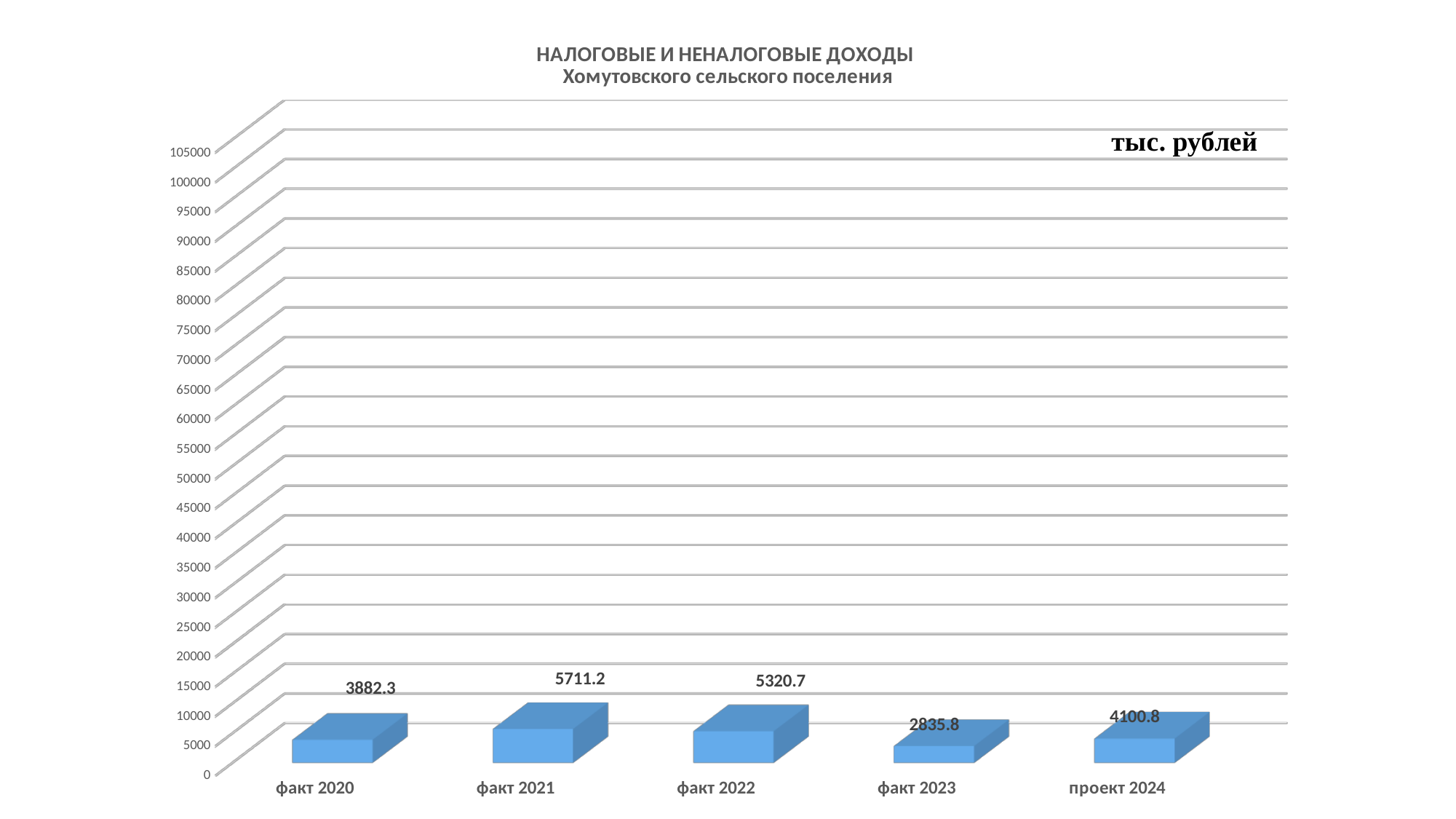
What is the value for факт 2021? 5711.2 Which category has the highest value? факт 2021 Which category has the lowest value? факт 2023 What unit is indicated on the chart? тыс. рублей Which is larger, the value for факт 2020 or the value for проект 2024? проект 2024 What is the difference between the values for проект 2024 and факт 2023? 1265 Is the value for факт 2021 greater or less than 10000? less What is the difference between the values for факт 2021 and факт 2022? 390.5 What kind of chart is shown on the slide? bar chart How many categories are shown on the x axis? 5 What is the value for проект 2024? 4100.8 What is the value for факт 2023? 2835.8